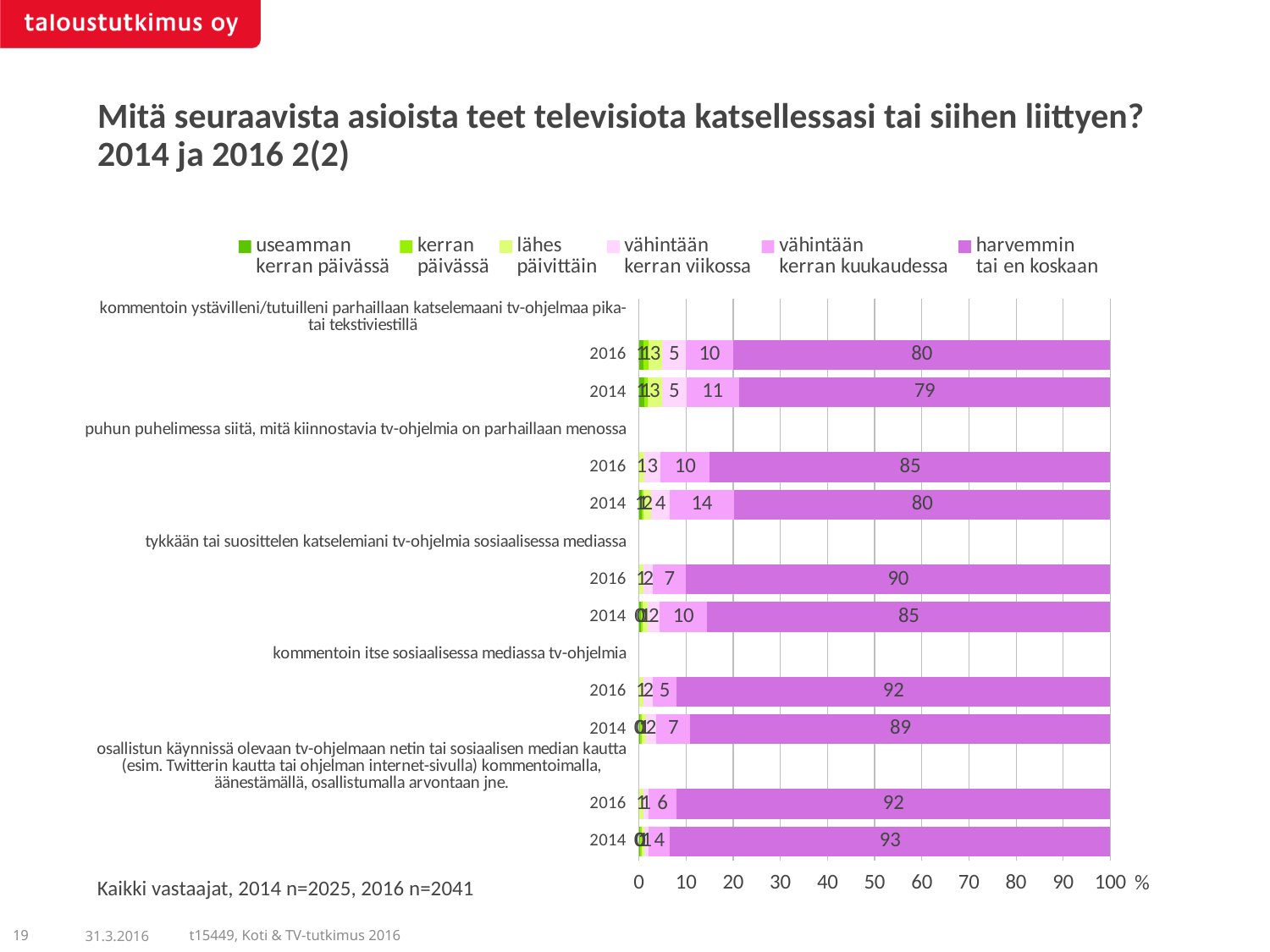
What is the 2016 value of 'harvemmin tai en koskaan' for 'kommentoin ystävilleni/tutuilleni parhaillaan katselemaani tv-ohjelmaa pika- tai tekstiviestillä'? 80 What is the 2016 value of 'harvemmin tai en koskaan' for 'tykkään tai suosittelen katselemiani tv-ohjelmia sosiaalisessa mediassa'? 90 What is the difference between the 2016 and 2014 'harvemmin tai en koskaan' values for 'tykkään tai suosittelen katselemiani tv-ohjelmia sosiaalisessa mediassa'? 5 What is the 2014 value of 'vähintään kerran kuukaudessa' for 'puhun puhelimessa siitä, mitä kiinnostavia tv-ohjelmia on parhaillaan menossa'? 14 Which bar has the lowest 'harvemmin tai en koskaan' value? 2014, kommentoin ystävilleni/tutuilleni parhaillaan katselemaani tv-ohjelmaa pika- tai tekstiviestillä (79) For 'kommentoin itse sosiaalisessa mediassa tv-ohjelmia', is the 'harvemmin tai en koskaan' value larger in 2016 or 2014? 2016 What kind of chart is shown on the slide? bar chart How many series does the legend list? 6 Which legend entry is shown with the darkest green colour? useamman kerran päivässä What is the 2014 value of 'harvemmin tai en koskaan' for 'puhun puhelimessa siitä, mitä kiinnostavia tv-ohjelmia on parhaillaan menossa'? 80 What is the 2014 value of 'harvemmin tai en koskaan' for 'kommentoin itse sosiaalisessa mediassa tv-ohjelmia'? 89 Which bar has the highest 'harvemmin tai en koskaan' value? 2014, osallistun käynnissä olevaan tv-ohjelmaan netin tai sosiaalisen median kautta (93)